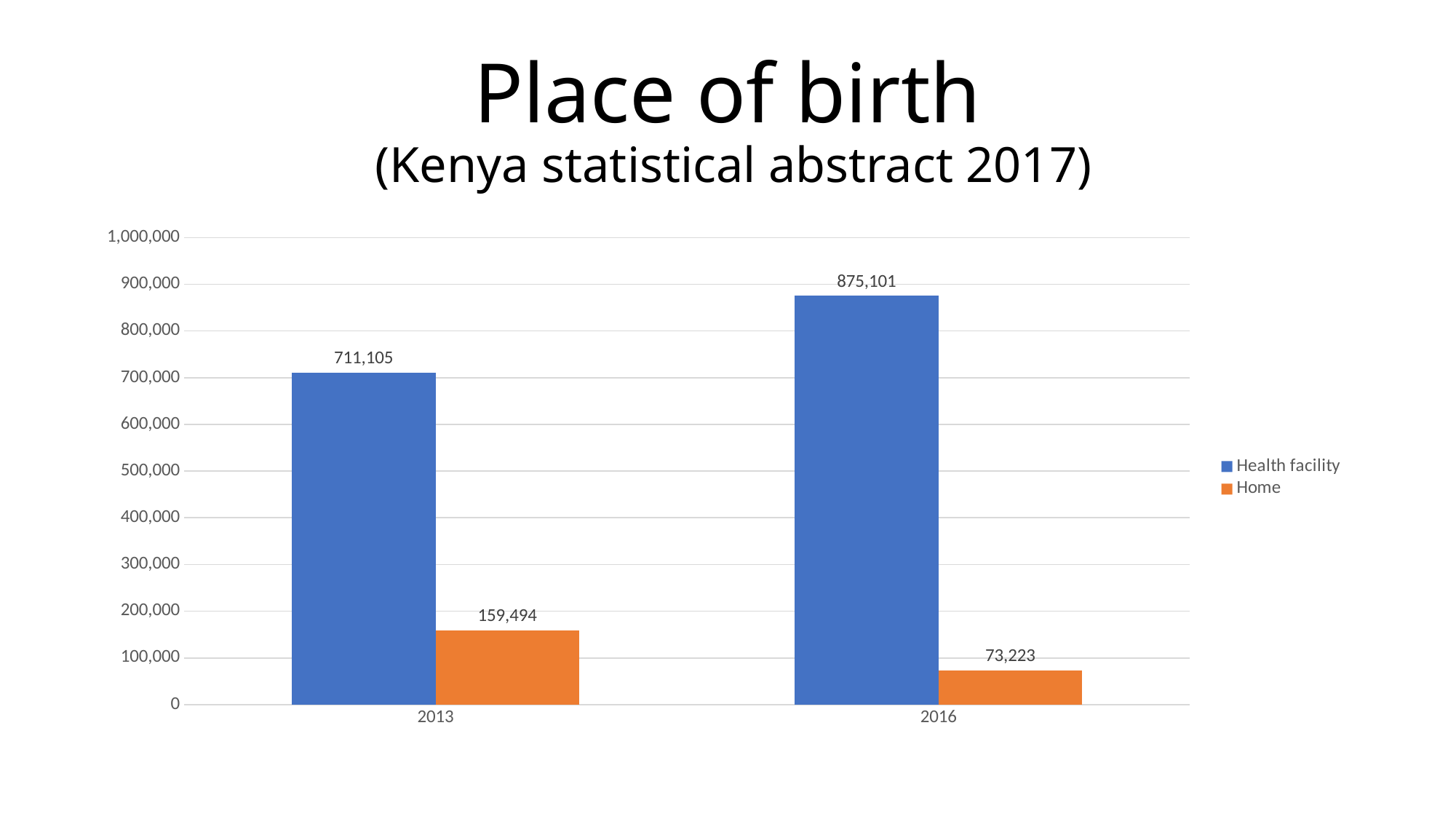
Which year has the lower value for Home? 2016 What is the value for Home in 2016? 73,223 What is the value for Home in 2013? 159,494 Which year has the higher value for Health facility? 2016 What is the difference between the Home values for 2013 and 2016? 86,271 Does the Home series rise or fall from 2013 to 2016? Fall What is the difference between the Health facility values for 2016 and 2013? 163,996 How many series does the legend list? 2 What is the value for Health facility in 2016? 875,101 What is the value for Health facility in 2013? 711,105 What kind of chart is shown on the slide? Bar chart Is the value for Home in 2013 greater or less than 200,000? less